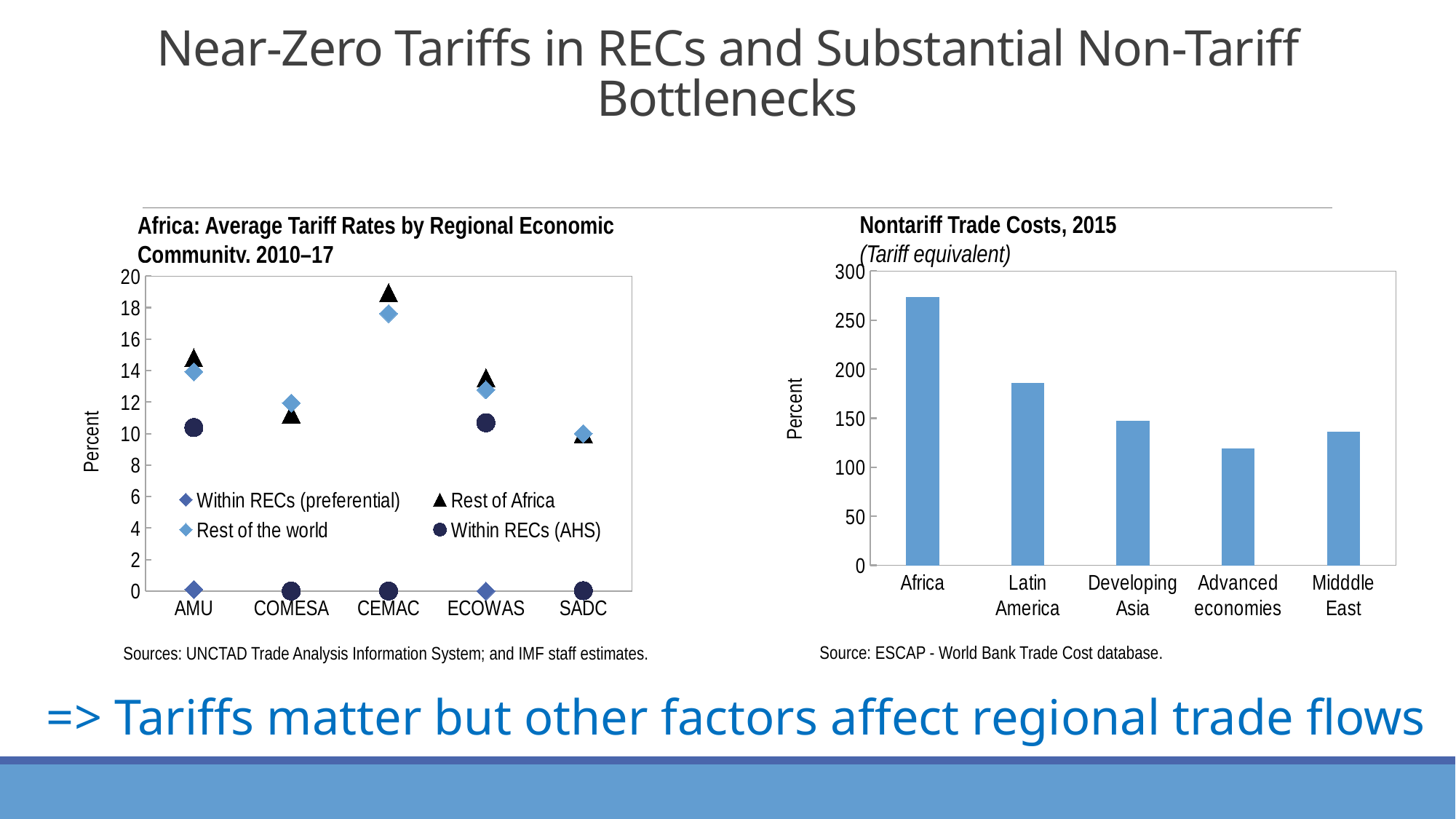
What kind of chart is the 'Nontariff Trade Costs, 2015' chart on the right? bar chart How many series does the legend list in the 'Africa: Average Tariff Rates by Regional Economic Community, 2010–17' chart? 4 In the 'Africa: Average Tariff Rates by Regional Economic Community, 2010–17' chart, for which community is the 'Rest of Africa' value highest? CEMAC In the 'Nontariff Trade Costs, 2015' chart, is the value for Africa greater or less than 250? greater In the 'Nontariff Trade Costs, 2015' chart, which region has the highest value? Africa In the 'Nontariff Trade Costs, 2015' chart, is the value for Latin America greater or less than 150? greater In the 'Nontariff Trade Costs, 2015' chart, which region has the lowest value? Advanced economies How many regional economic communities are shown on the x axis of the 'Africa: Average Tariff Rates by Regional Economic Community, 2010–17' chart? 5 In the 'Africa: Average Tariff Rates by Regional Economic Community, 2010–17' chart, is the 'Rest of the world' value for CEMAC greater or less than 16? greater In the 'Nontariff Trade Costs, 2015' chart, which is larger, the value for Latin America or the value for Middle East? Latin America How many regions are shown on the x axis of the 'Nontariff Trade Costs, 2015' chart? 5